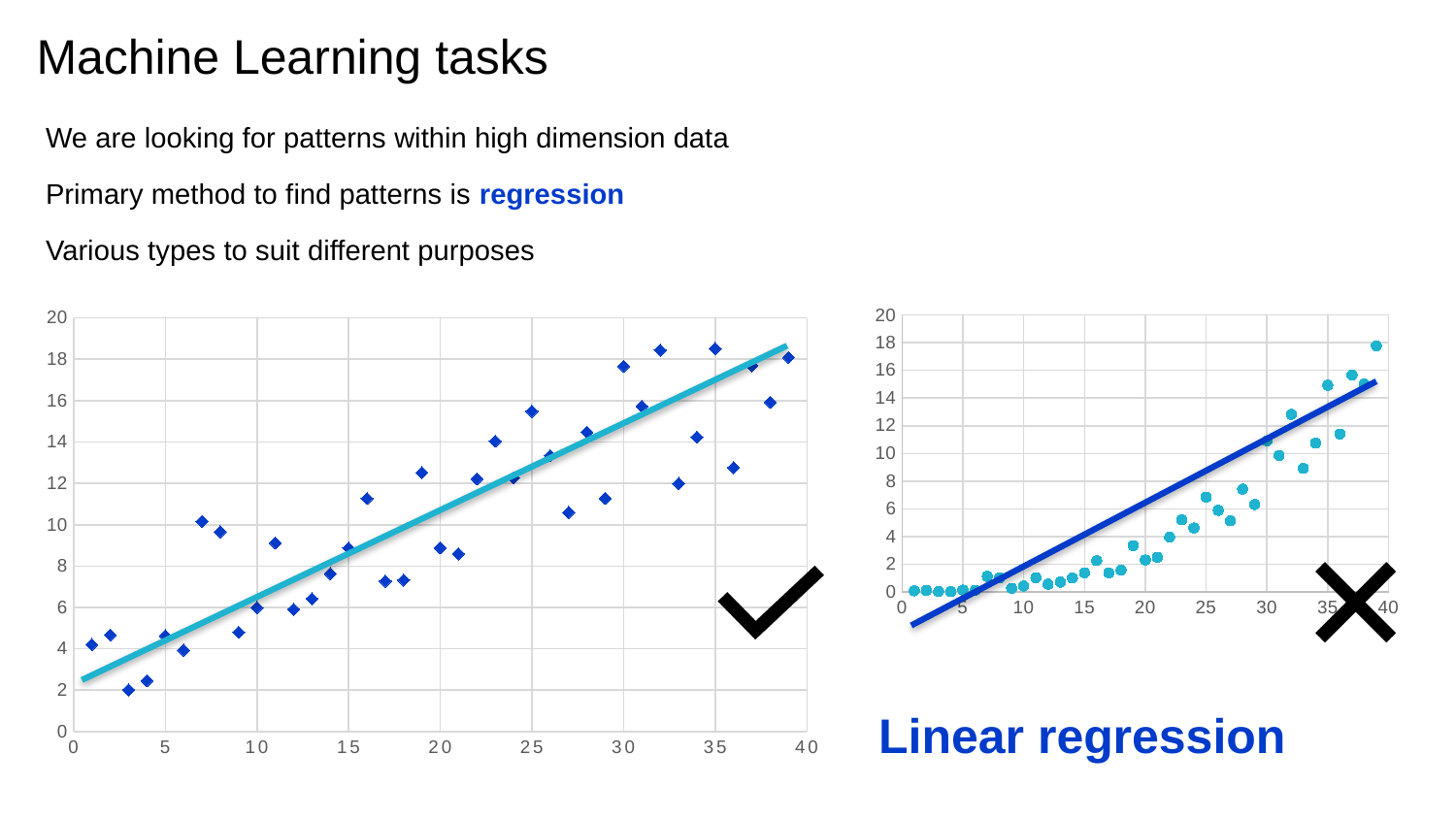
In the right chart, is the value for x = 20 greater or less than 6? less In the left chart, is the value for x = 30 greater or less than 14? greater In the left chart, do the plotted values generally rise or fall as x increases? rise In the right chart, what is the highest value shown on the x axis? 40 In the left chart, is the value for x = 3 greater or less than 4? less In the right chart, do the plotted values generally rise or fall as x increases? rise In the left chart, what is the highest value shown on the y axis? 20 What kind of chart is the chart on the left of the slide? scatter chart What kind of chart is the chart on the right of the slide? scatter chart